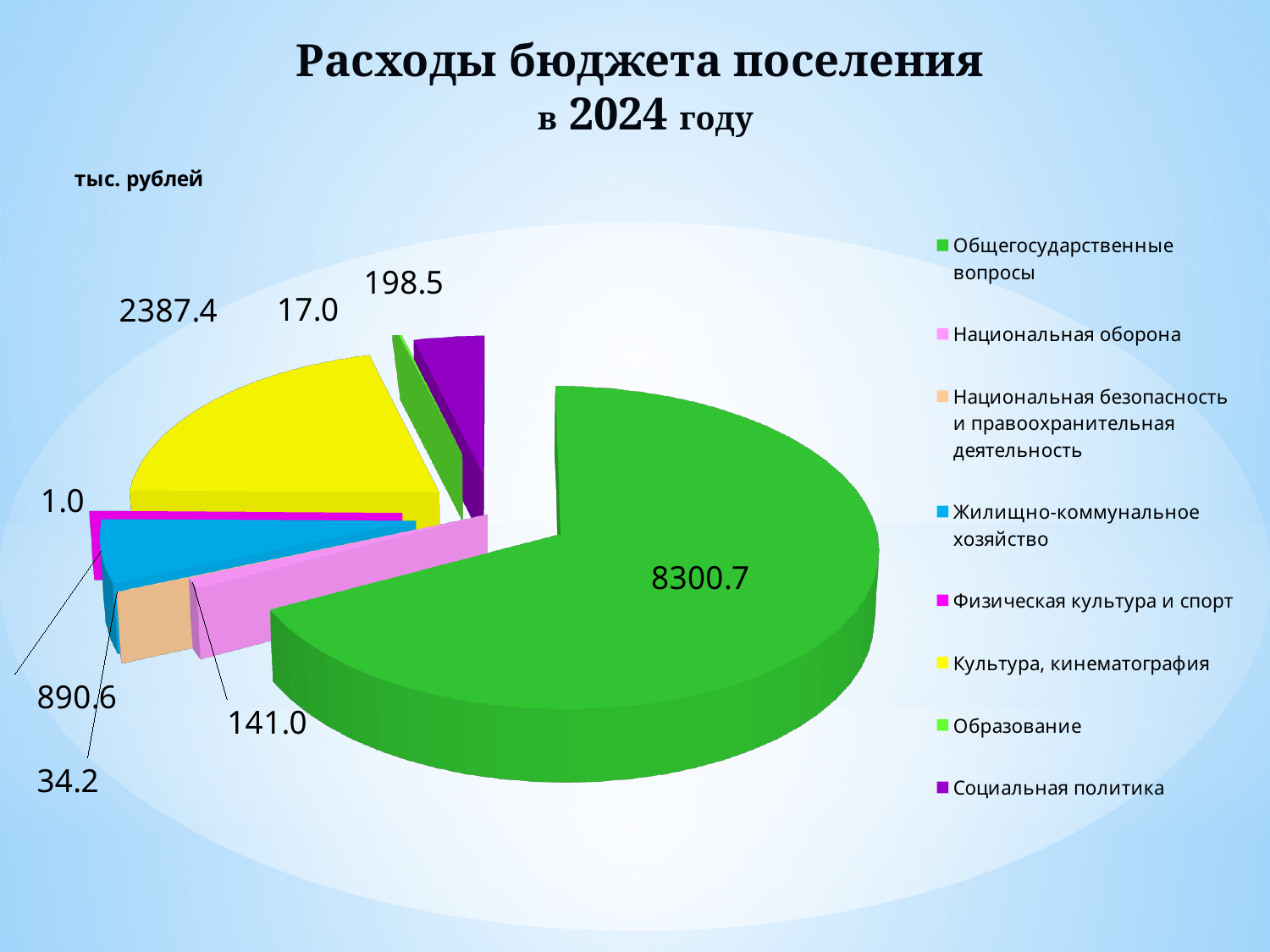
What is the value for Социальная политика? 198.5 What is the difference between the values for Социальная политика and Образование? 181.5 What unit is stated for the values on the chart? тыс. рублей What type of chart is shown on the slide? pie chart Which is larger: Жилищно-коммунальное хозяйство or Национальная оборона? Жилищно-коммунальное хозяйство How many categories does the legend list? 8 Which category has the largest slice? Общегосударственные вопросы Which category has the smallest value? Физическая культура и спорт What is the value for Жилищно-коммунальное хозяйство? 890.6 What is the difference between the values for Общегосударственные вопросы and Культура, кинематография? 5913.3 What is the value for Культура, кинематография? 2387.4 What is the value for Общегосударственные вопросы? 8300.7